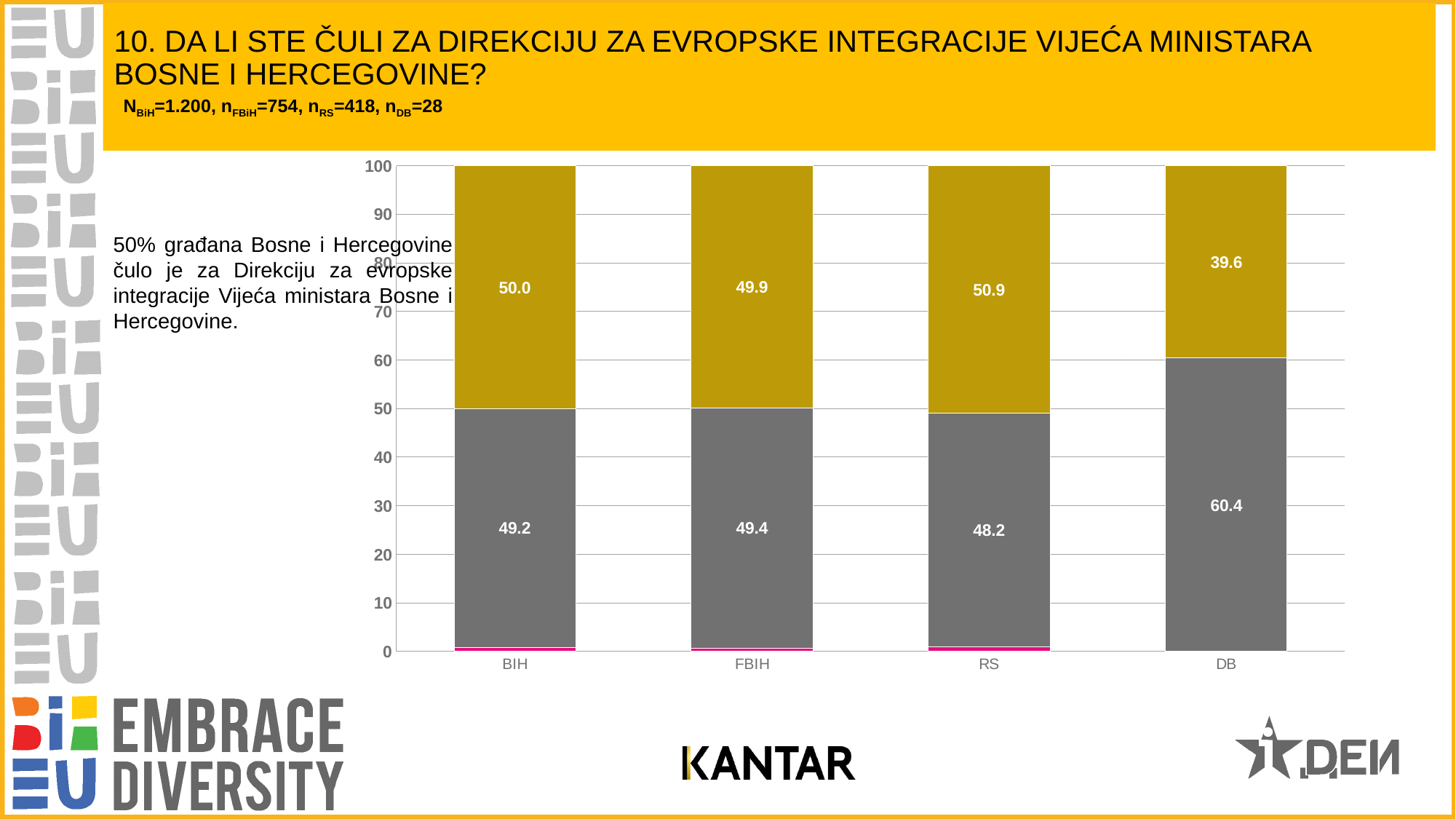
Which category has the highest value in the grey segment? DB How many categories are shown on the x axis? 4 What is the difference between the grey segment and the gold segment for DB? 20.8 Which is larger: the gold segment for BIH or the gold segment for DB? BIH What is the value of the gold (top) segment for FBIH? 49.9 Is the value of the small pink segment at the bottom of the BIH bar greater or less than 10? less What is the value of the grey segment for DB? 60.4 What is the value of the grey segment for RS? 48.2 Which category has the lowest value in the gold (top) segment? DB What is the value of the gold (top) segment for BIH? 50.0 Which category has the highest value in the gold (top) segment? RS What kind of chart is shown on the slide? Stacked bar chart